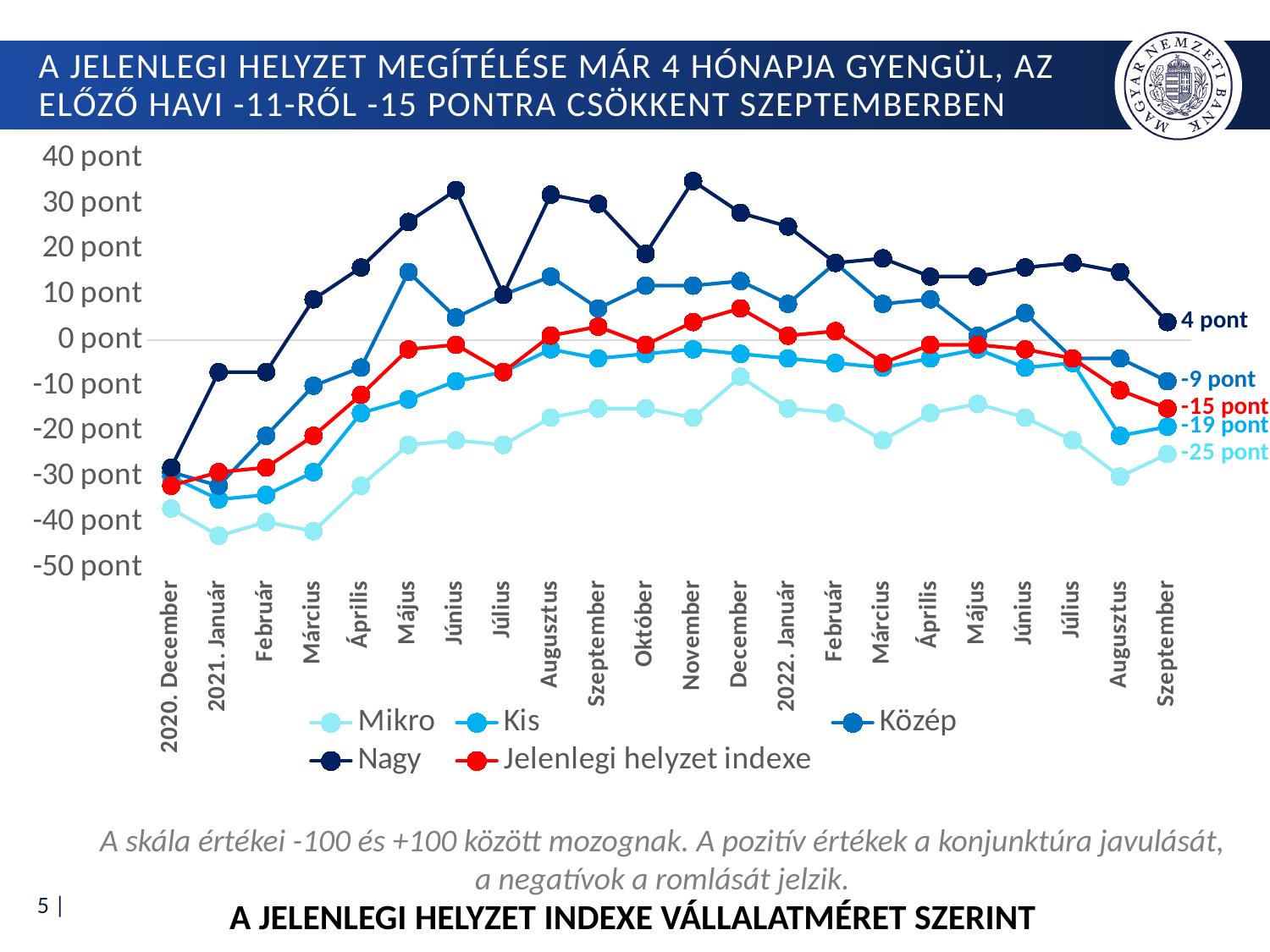
Which series has the highest value at the last point (Szeptember 2022)? Nagy What is the value of the Mikro series at the last point (Szeptember 2022)? -25 pont Is the value of the Nagy series in November 2021 greater or less than 30 pont? greater What is the value of the Kis series at the last point (Szeptember 2022)? -19 pont What type of chart is shown on the slide? line chart How many months (data points) are plotted along the x axis? 22 What is the value of the Nagy series in Szeptember (2022), the last point on the chart? 4 pont What is the difference between the Nagy and Mikro values at the last point (Szeptember 2022)? 29 pont Which series has the lowest value at the last point (Szeptember 2022)? Mikro What is the value of the Közép series at the last point (Szeptember 2022)? -9 pont How many series does the legend list? 5 What is the value of the Jelenlegi helyzet indexe series at the last point (Szeptember 2022)? -15 pont